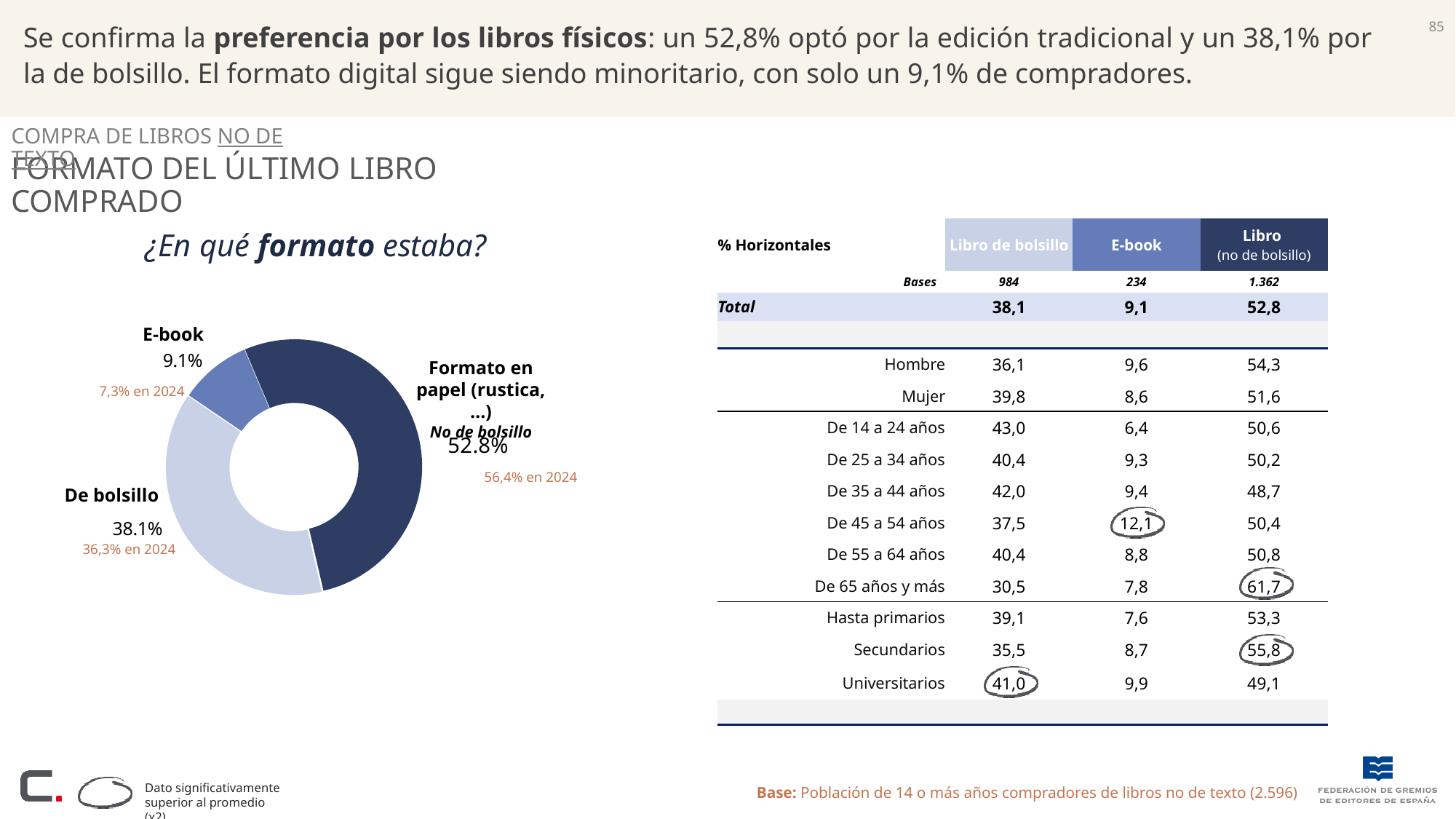
Which slice of the donut chart is the largest? Formato en papel (rustica, ...) No de bolsillo How many slices does the donut chart have? 3 According to the orange annotation next to the donut chart, what was the De bolsillo share in 2024? 36,3% What kind of chart is shown on the left of the slide? Pie chart (donut) What is the title shown above the donut chart? ¿En qué formato estaba? In the donut chart, which is larger: De bolsillo or E-book? De bolsillo According to the orange annotation next to the donut chart, what was the E-book share in 2024? 7,3% What percentage does the donut chart show for De bolsillo? 38.1% Which slice of the donut chart is the smallest? E-book What percentage does the donut chart show for E-book? 9.1% What percentage does the donut chart show for Formato en papel (rustica, ...) No de bolsillo? 52.8% In the donut chart, what is the difference in percentage points between Formato en papel (No de bolsillo) and De bolsillo? 14.7 percentage points